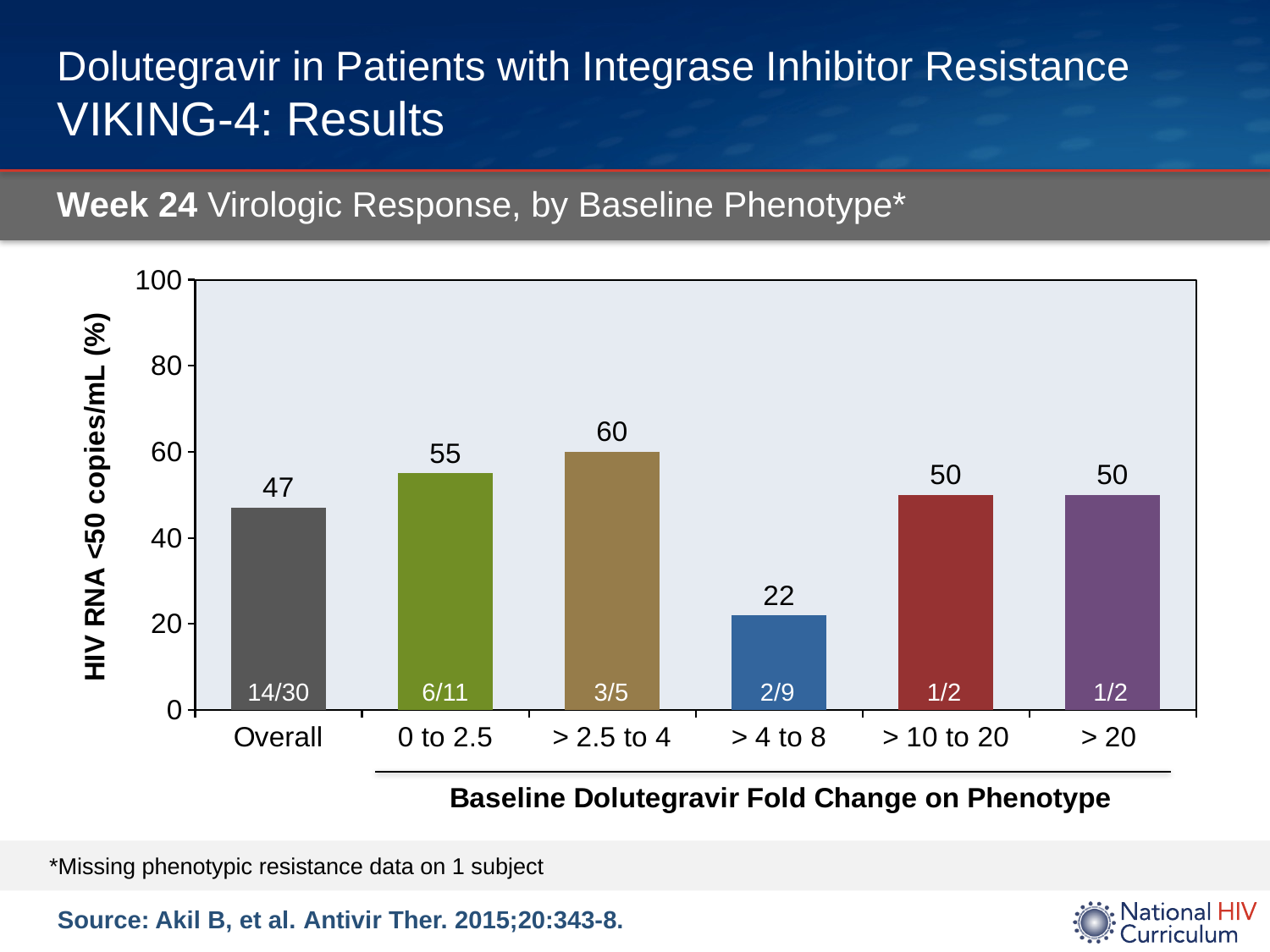
Which category has the lowest value? > 4 to 8 Is the value for Overall greater or less than 40? greater Which is larger, the value for 0 to 2.5 or the value for > 10 to 20? 0 to 2.5 What is the value for the Overall category? 47 What is the value for the 0 to 2.5 fold change category? 55 What kind of chart is shown on the slide? Bar chart How many categories are shown on the x axis? 6 What is the difference between the values for > 2.5 to 4 and > 4 to 8? 38 Which category has the highest value? > 2.5 to 4 What is the label of the y axis? HIV RNA <50 copies/mL (%) What is the value for the > 4 to 8 fold change category? 22 What fraction of subjects is shown inside the Overall bar? 14/30